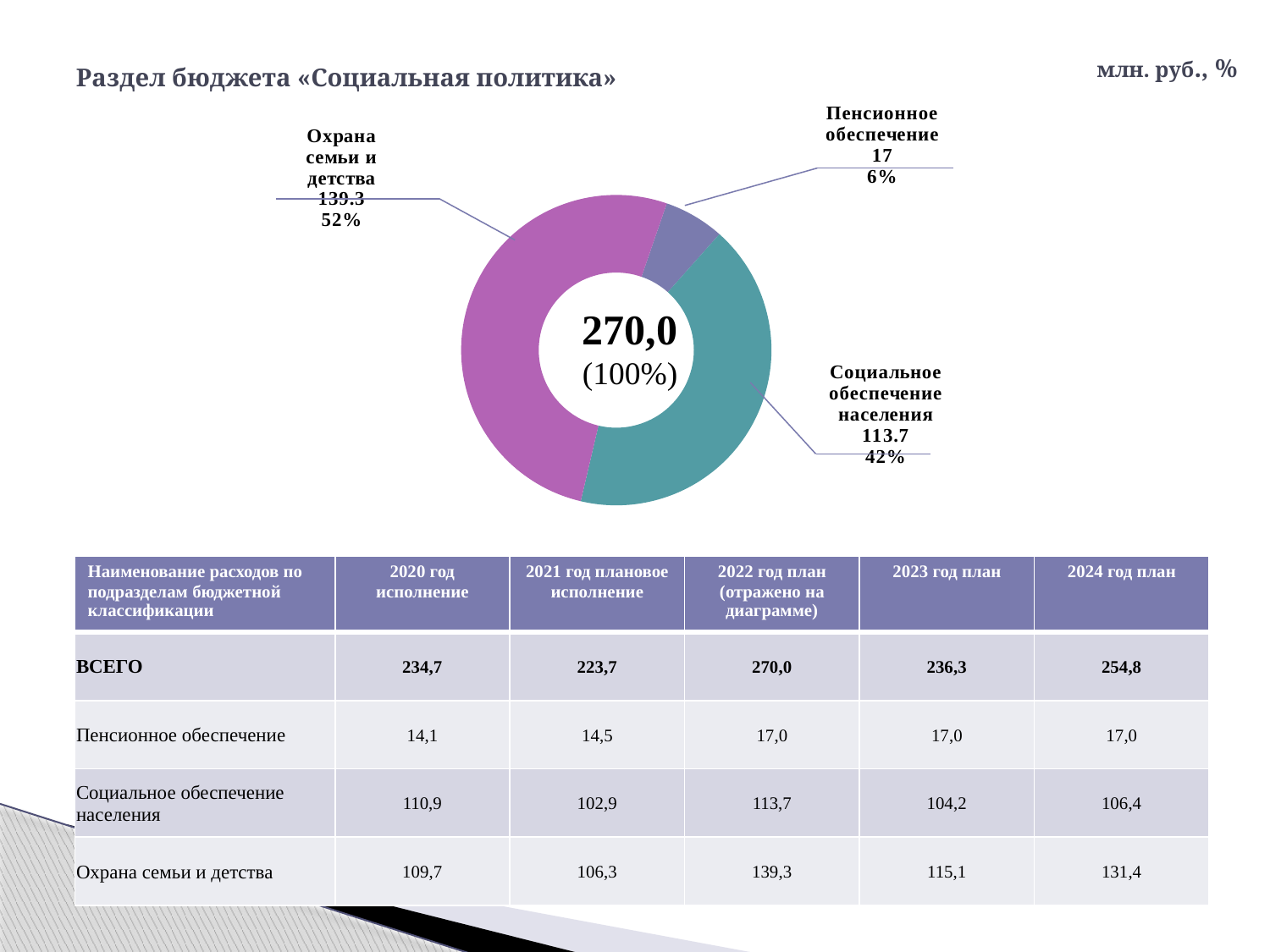
Which category has the smallest slice in the pie chart? Пенсионное обеспечение What share of the pie does Социальное обеспечение населения represent? 42% How many slices does the pie chart have? 3 What share of the pie does Пенсионное обеспечение represent? 6% What is the value shown for Социальное обеспечение населения in the pie chart? 113.7 What share of the pie does Охрана семьи и детства represent? 52% What type of chart is shown on the slide? Pie chart (donut) What is the value shown for Охрана семьи и детства in the pie chart? 139.3 What is the difference between the values for Охрана семьи и детства and Социальное обеспечение населения in the pie chart? 25.6 What total value is shown in the centre of the donut chart? 270,0 What is the value shown for Пенсионное обеспечение in the pie chart? 17 Which category has the largest slice in the pie chart? Охрана семьи и детства